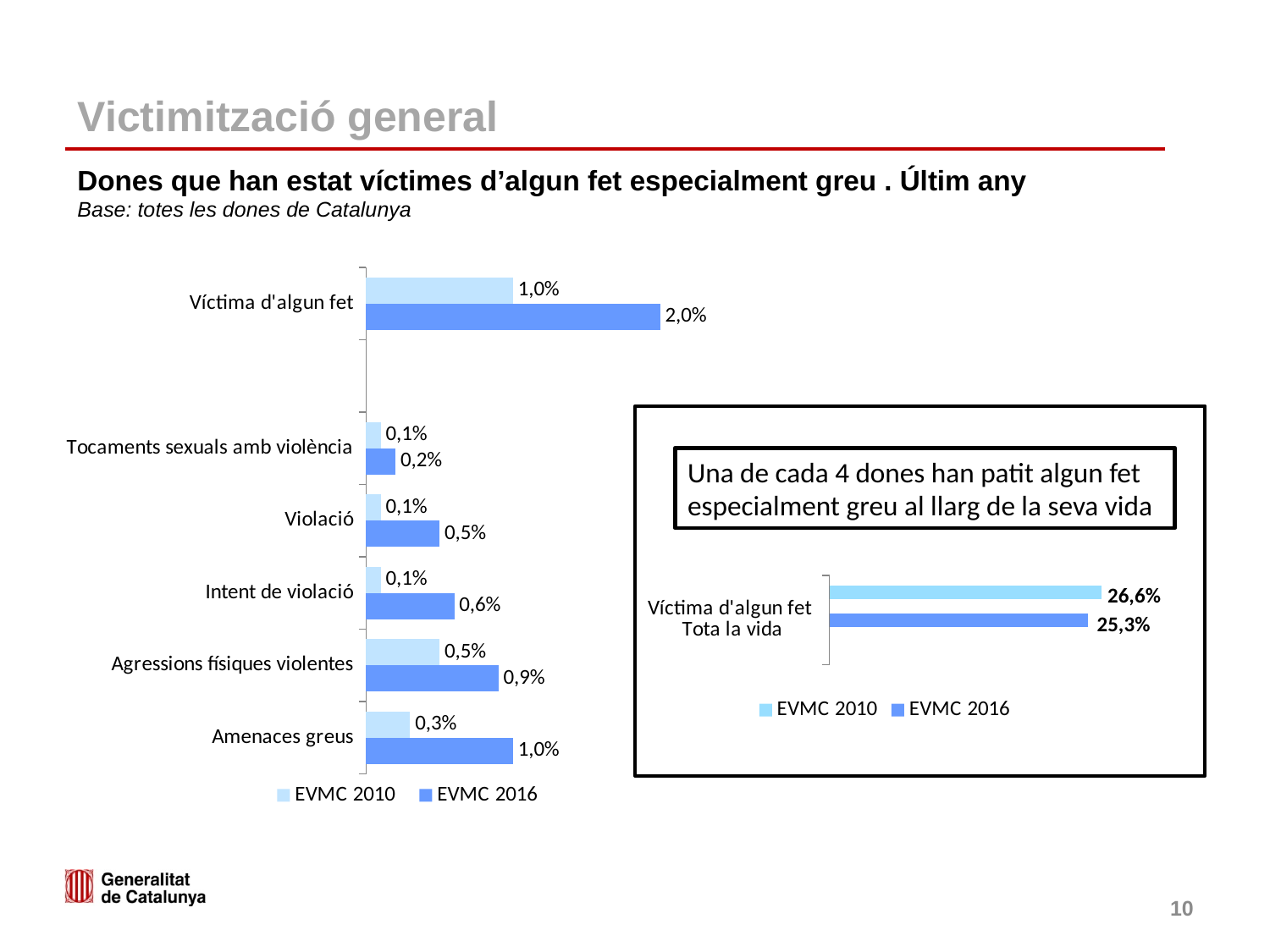
In the left chart, which category has the highest EVMC 2016 value? Víctima d'algun fet How many series does the legend of the left chart list? 2 In the left chart, what is the EVMC 2016 value for Víctima d'algun fet? 2,0% In the left chart, which category has the lowest EVMC 2016 value? Tocaments sexuals amb violència In the right chart (Víctima d'algun fet Tota la vida), what is the EVMC 2010 value? 26,6% In the left chart, what is the difference between the EVMC 2016 and EVMC 2010 values for Violació? 0,4% In the left chart, which is larger for Amenaces greus: the EVMC 2010 value or the EVMC 2016 value? EVMC 2016 In the left chart, what is the EVMC 2010 value for Agressions físiques violentes? 0,5% In the left chart, what is the EVMC 2016 value for Intent de violació? 0,6% In the left chart, what is the EVMC 2016 value for Amenaces greus? 1,0% How many categories are shown in the left chart? 6 In the right chart (Víctima d'algun fet Tota la vida), what is the difference between the EVMC 2010 and EVMC 2016 values? 1,3%